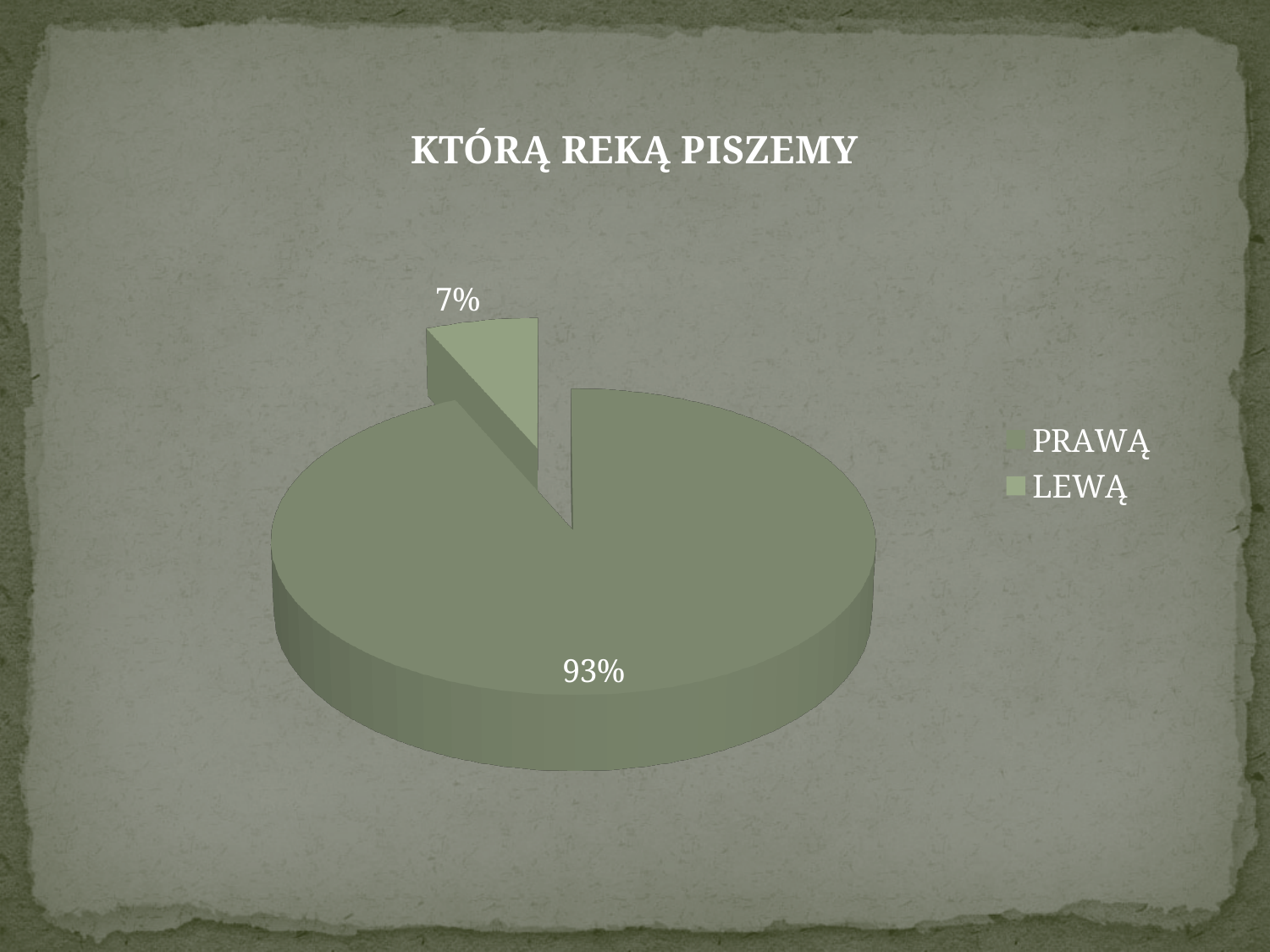
Which is larger, the share for PRAWĄ or the share for LEWĄ? PRAWĄ Which category has the smallest slice of the pie? LEWĄ What is the difference in percentage points between PRAWĄ and LEWĄ? 86 What share of the pie does LEWĄ take? 7% What is the title of the chart? KTÓRĄ REKĄ PISZEMY What kind of chart is shown on the slide? pie chart Which slice is pulled out from the rest of the pie? LEWĄ How many categories does the pie chart show? 2 How many entries does the legend list? 2 What share of the pie does PRAWĄ take? 93% Which category has the largest slice of the pie? PRAWĄ